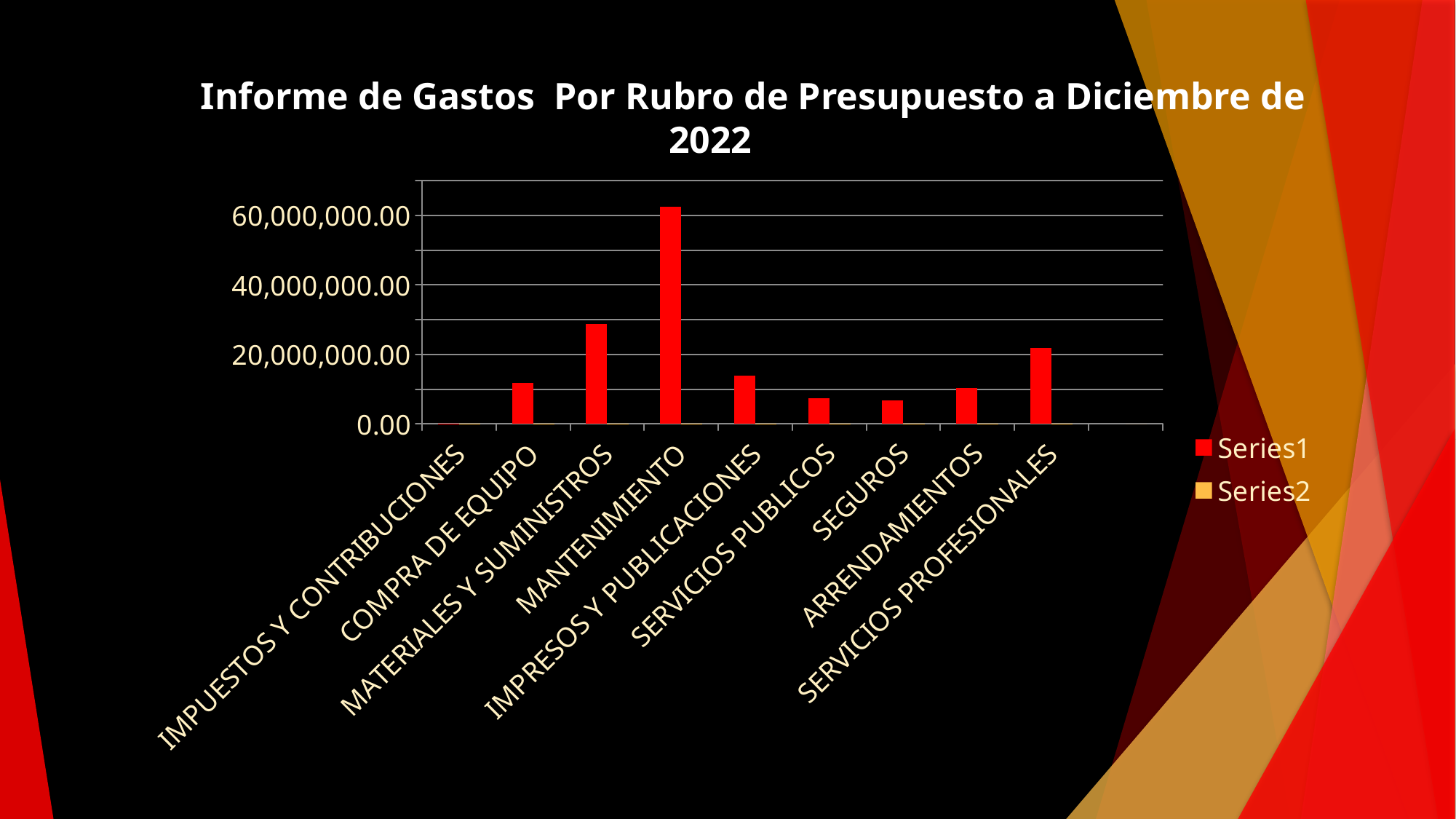
Is the value for MATERIALES Y SUMINISTROS greater or less than 20,000,000.00? greater Which category has the lowest value in the chart? IMPUESTOS Y CONTRIBUCIONES What kind of chart is shown on the slide? Bar chart Which is larger, the value for MATERIALES Y SUMINISTROS or the value for SERVICIOS PROFESIONALES? MATERIALES Y SUMINISTROS Which colour represents Series1 in the legend? Red Is the value for COMPRA DE EQUIPO greater or less than 20,000,000.00? less Which category has the highest value in the chart? MANTENIMIENTO What is the title of the chart? Informe de Gastos Por Rubro de Presupuesto a Diciembre de 2022 How many categories are shown on the x axis of the chart? 9 How many series does the legend list? 2 Is the value for MANTENIMIENTO greater or less than 40,000,000.00? greater